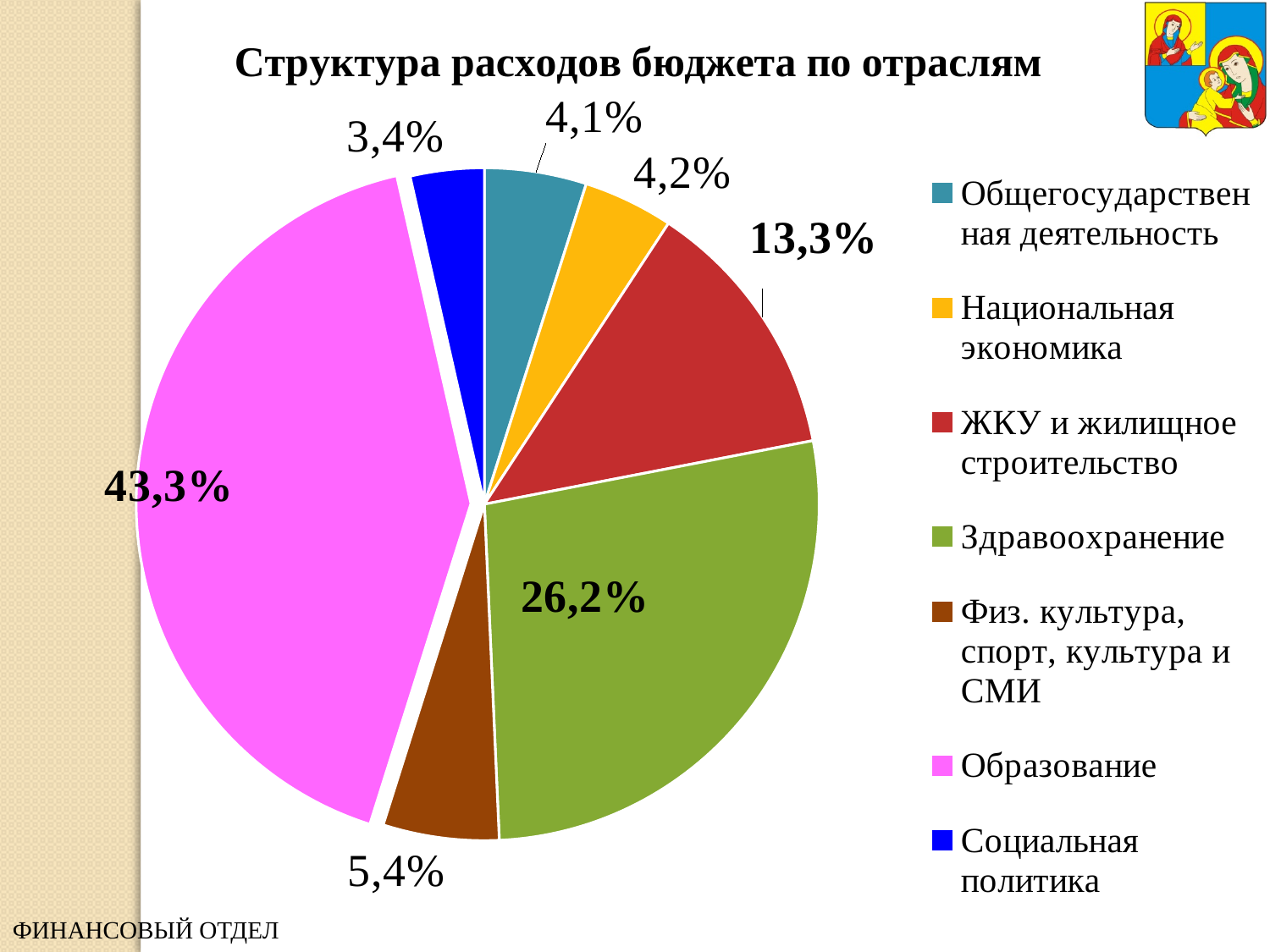
What is the difference between the shares of Образование and Здравоохранение? 17,1% Which category has the smallest share of the pie? Социальная политика What is the value for ЖКУ и жилищное строительство? 13,3% How many categories does the legend list? 7 What is the title of the chart? Структура расходов бюджета по отраслям What is the value for Социальная политика? 3,4% What share of the pie does Здравоохранение have? 26,2% What share of the pie does Образование have? 43,3% What type of chart is shown on the slide? pie chart Which is larger, the share of ЖКУ и жилищное строительство or the share of Физ. культура, спорт, культура и СМИ? ЖКУ и жилищное строительство Which category has the largest share of the pie? Образование What is the value for Физ. культура, спорт, культура и СМИ? 5,4%